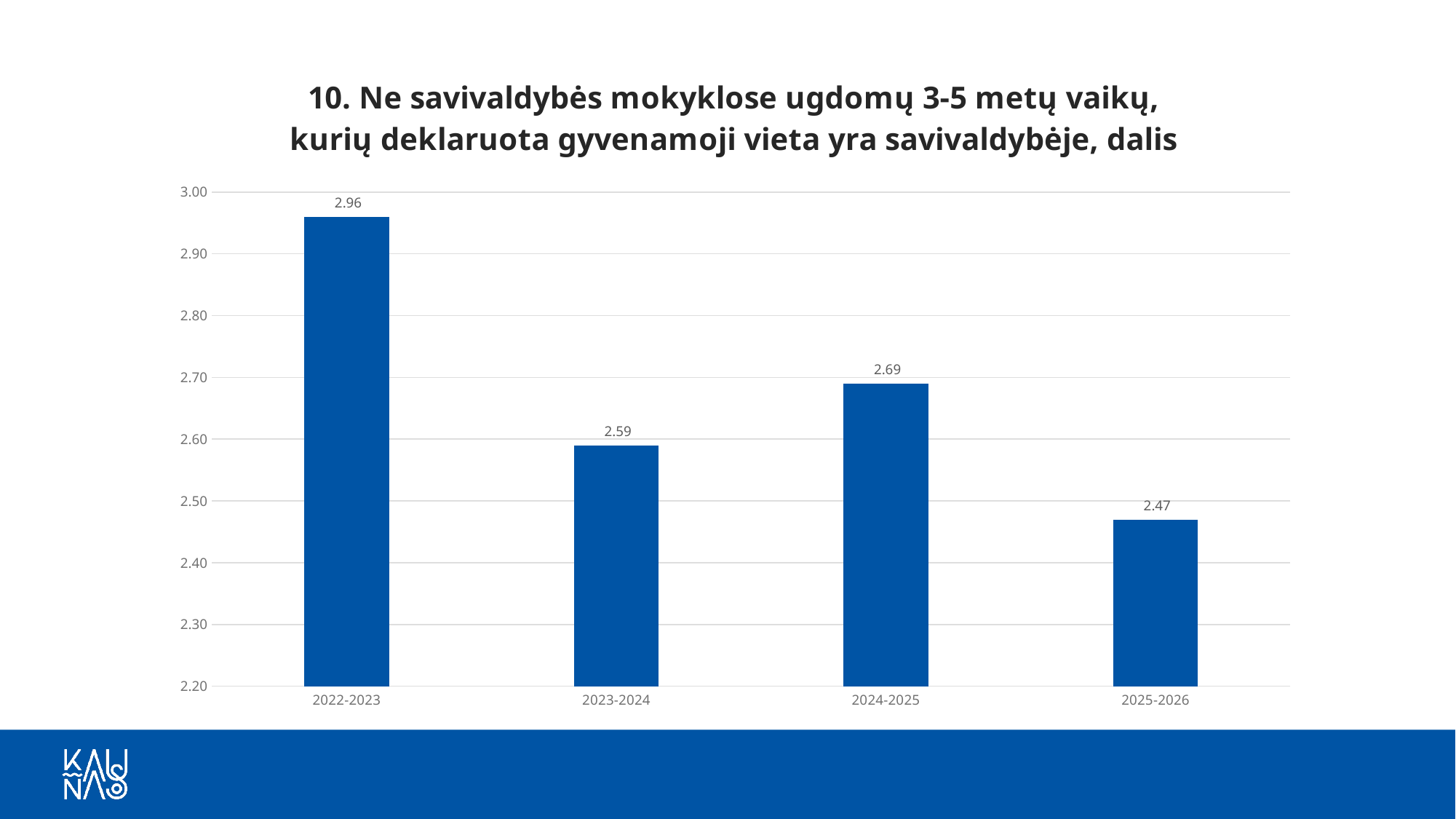
What is the value for 2023-2024? 2.59 What is the value for 2025-2026? 2.47 How many school years are shown on the x axis? 4 Which school year has the lowest value? 2025-2026 What is the difference between the values for 2022-2023 and 2025-2026? 0.49 Which school year has the highest value? 2022-2023 Which is larger, the value for 2023-2024 or the value for 2024-2025? 2024-2025 Is the value for 2025-2026 greater or less than 2.50? less What is the value for 2024-2025? 2.69 What is the value for 2022-2023? 2.96 What is the difference between the values for 2024-2025 and 2023-2024? 0.10 What kind of chart is shown on the slide? bar chart